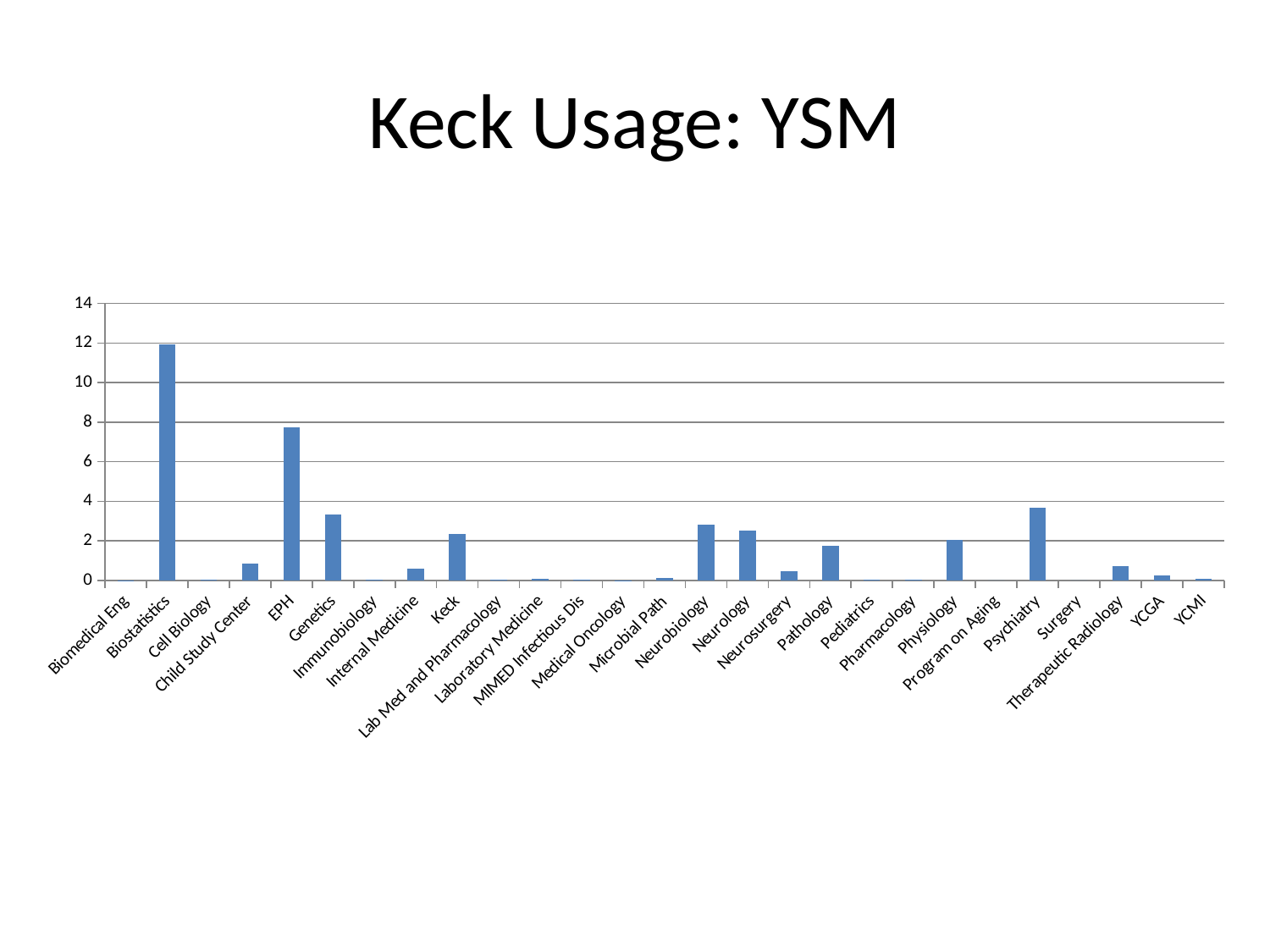
Is the value for Genetics greater or less than 2? greater Is the value for Pathology greater or less than 2? less Which has the larger value, EPH or Genetics? EPH Is the value for Child Study Center greater or less than 2? less How many departments are listed along the x axis? 27 Which has the larger value, Psychiatry or Neurobiology? Psychiatry What is the title of the chart? Keck Usage: YSM What is the highest value shown on the y axis? 14 Which department has the highest value in the chart? Biostatistics What kind of chart is shown on the slide? bar chart